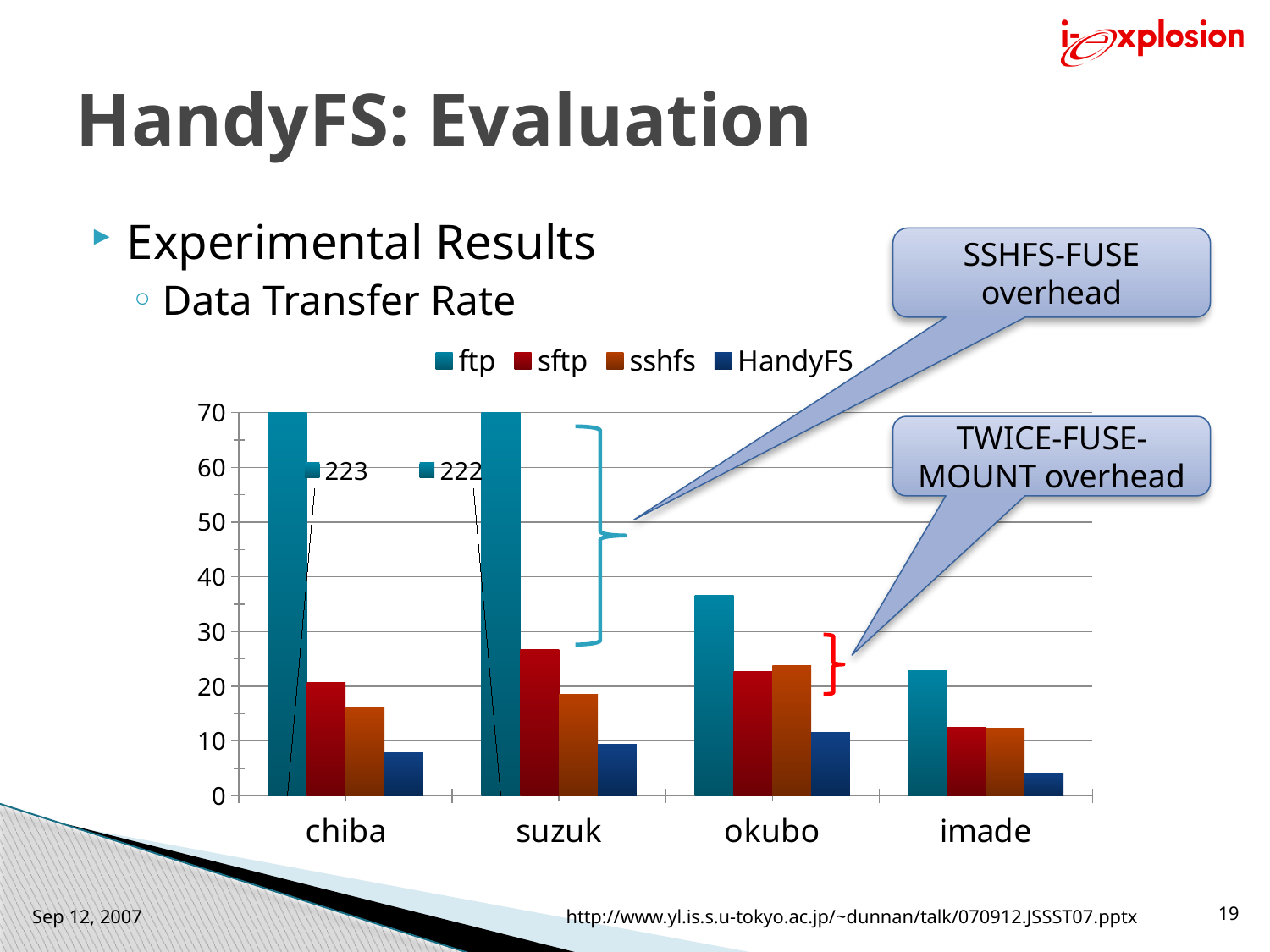
Which category has the highest ftp value? chiba What kind of chart is shown on the slide? bar chart How many series does the legend list? 4 What is the ftp data transfer rate for chiba? 223 What is the ftp data transfer rate for suzuk? 222 Is the ftp value for okubo greater or less than 30? greater Which category has the lowest HandyFS value? imade What is the difference between the ftp values for chiba and suzuk? 1 Is the sftp value for suzuk greater or less than 20? greater Do the ftp values rise or fall from chiba to imade along the x axis? fall Is the HandyFS value for imade greater or less than 10? less How many categories are shown on the x axis? 4